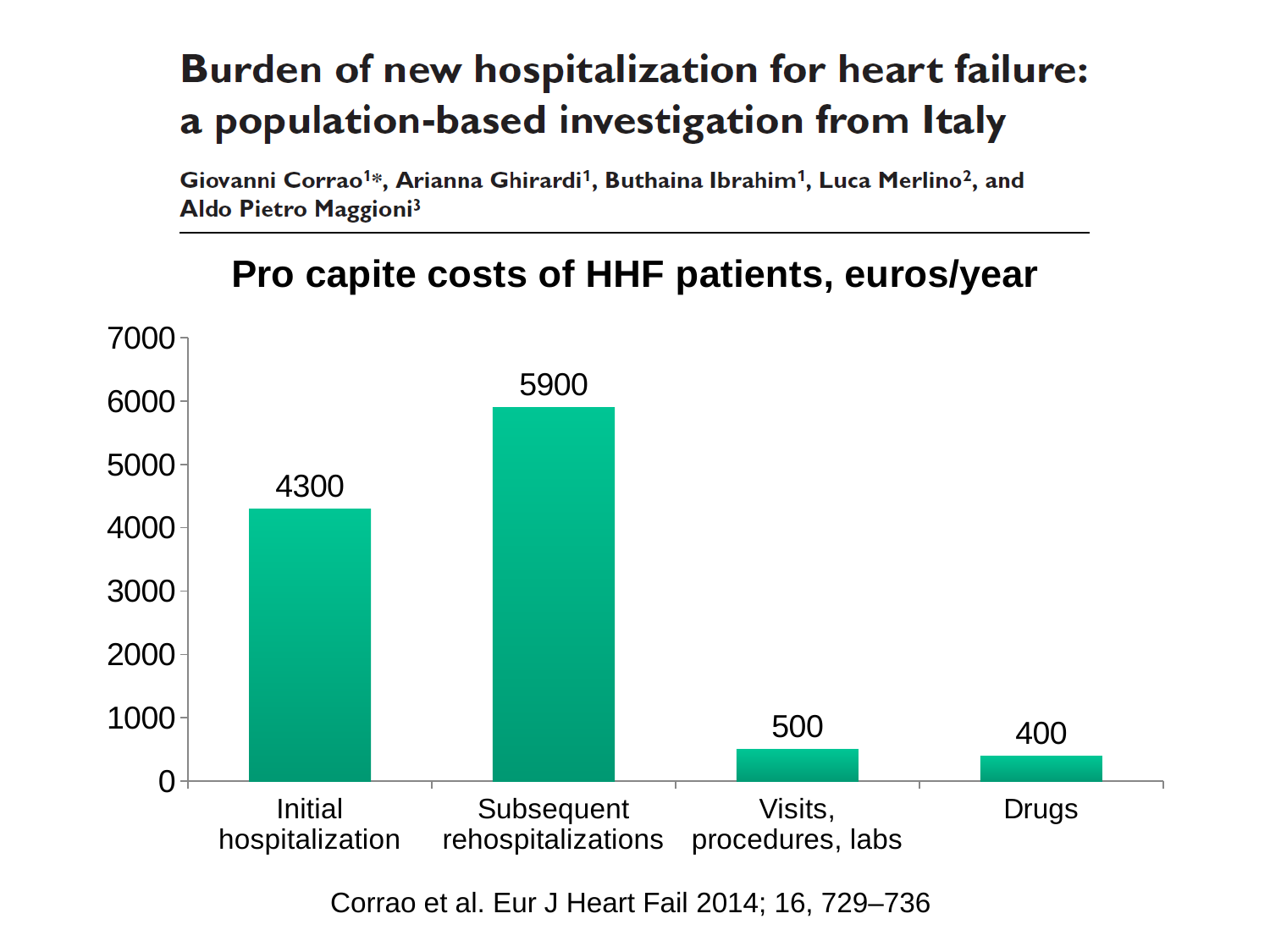
What is the difference between the cost for Visits, procedures, labs and Drugs? 100 Which is larger, the cost for Initial hospitalization or for Subsequent rehospitalizations? Subsequent rehospitalizations What is the pro capite cost for Drugs? 400 What kind of chart is shown on the slide? Bar chart Which category has the lowest pro capite cost? Drugs What is the pro capite cost for Subsequent rehospitalizations? 5900 What is the pro capite cost for Initial hospitalization? 4300 What is the title of the chart? Pro capite costs of HHF patients, euros/year How many categories are shown in the chart? 4 What is the pro capite cost for Visits, procedures, labs? 500 What is the difference between the cost for Subsequent rehospitalizations and Initial hospitalization? 1600 Which category has the highest pro capite cost? Subsequent rehospitalizations